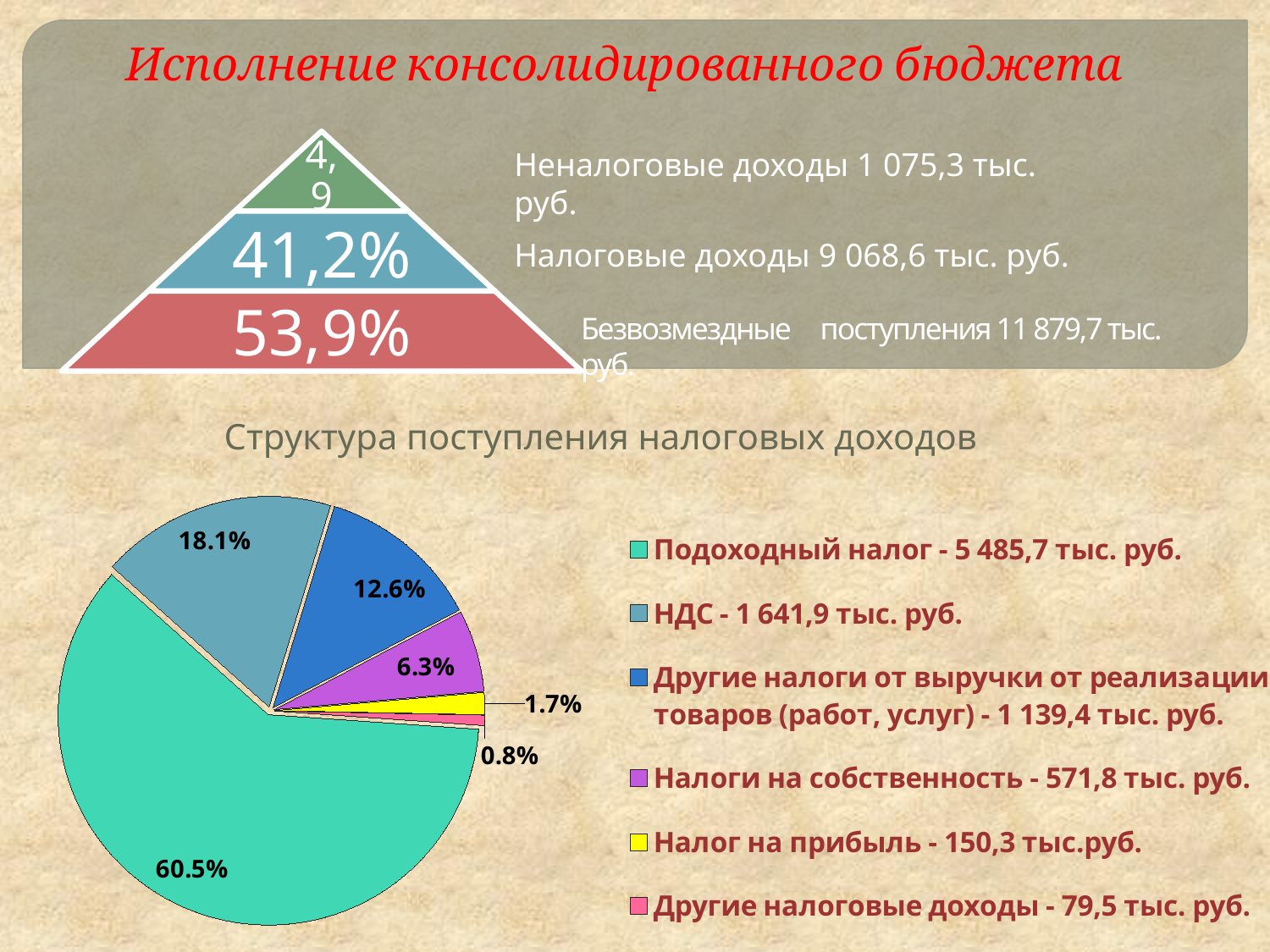
In the pie chart, what share is labelled for Налог на прибыль? 1.7% How many slices does the pie chart have? 6 In the pie chart, what share is labelled for Подоходный налог? 60.5% In the pie chart, what share is labelled for Другие налоговые доходы? 0.8% Which category has the smallest slice in the pie chart? Другие налоговые доходы Which category has the largest slice in the pie chart? Подоходный налог By how many percentage points does the Подоходный налог slice exceed the НДС slice in the pie chart? 42.4 percentage points According to the pie chart legend, what amount is given for НДС? 1 641,9 тыс. руб. What kind of chart is shown under the heading "Структура поступления налоговых доходов"? pie chart